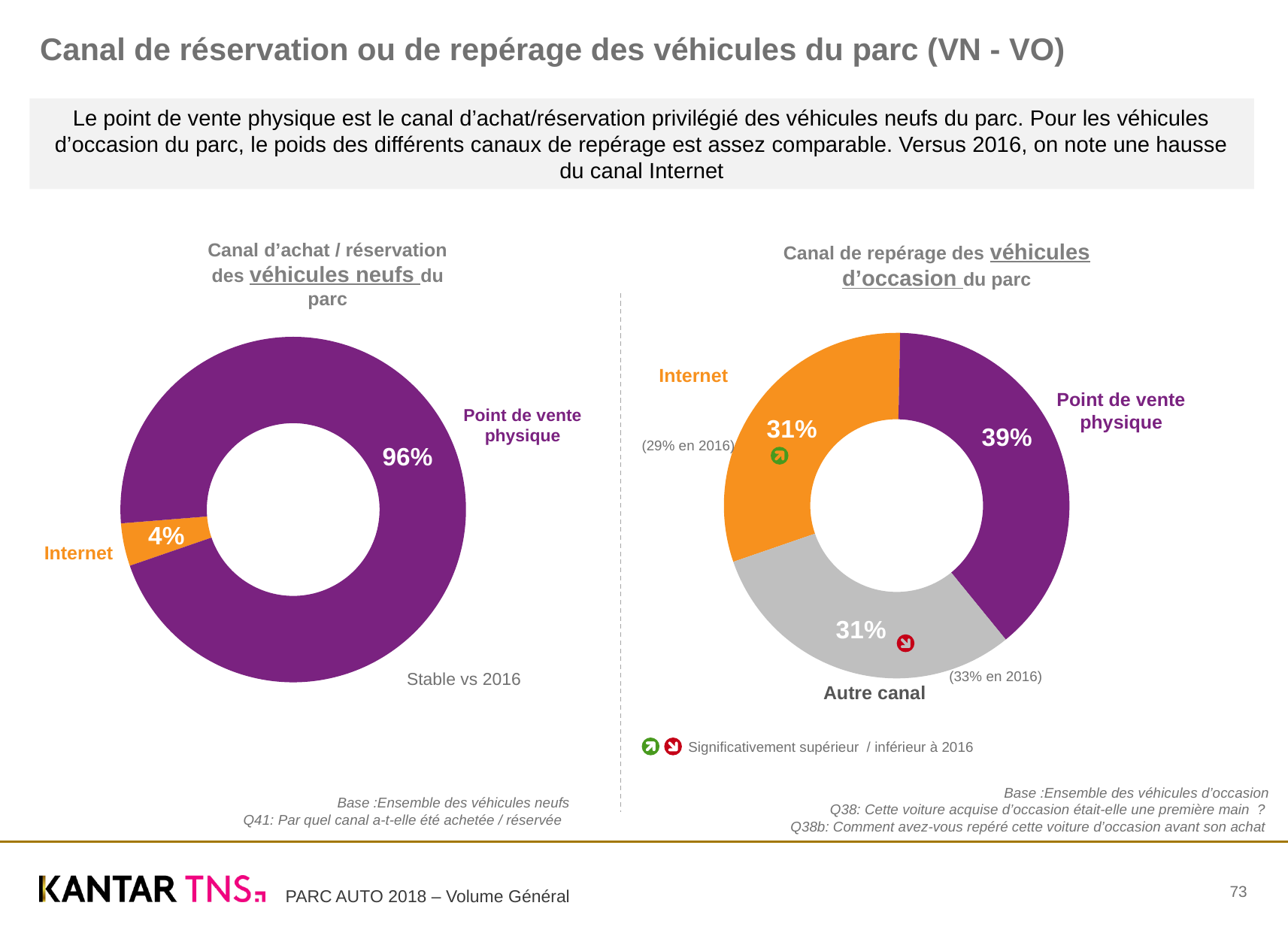
In the right chart (véhicules d'occasion), what is the value for Point de vente physique? 39% What kind of chart is the left chart (véhicules neufs)? Pie chart (donut) In the left chart (véhicules neufs), what is the difference between Point de vente physique and Internet? 92% In the right chart (véhicules d'occasion), how many categories are shown? 3 In the right chart (véhicules d'occasion), which category has the highest value? Point de vente physique In the right chart (véhicules d'occasion), what is the value for Autre canal? 31% In the right chart (véhicules d'occasion), what is the difference between Point de vente physique and Internet? 8% In the right chart (véhicules d'occasion), what was the value for Internet in 2016? 29% In the left chart (véhicules neufs), what is the value for Point de vente physique? 96% In the left chart (véhicules neufs), which category has the lowest value? Internet In the left chart (véhicules neufs), what is the value for Internet? 4% In the right chart (véhicules d'occasion), what is the value for Internet? 31%